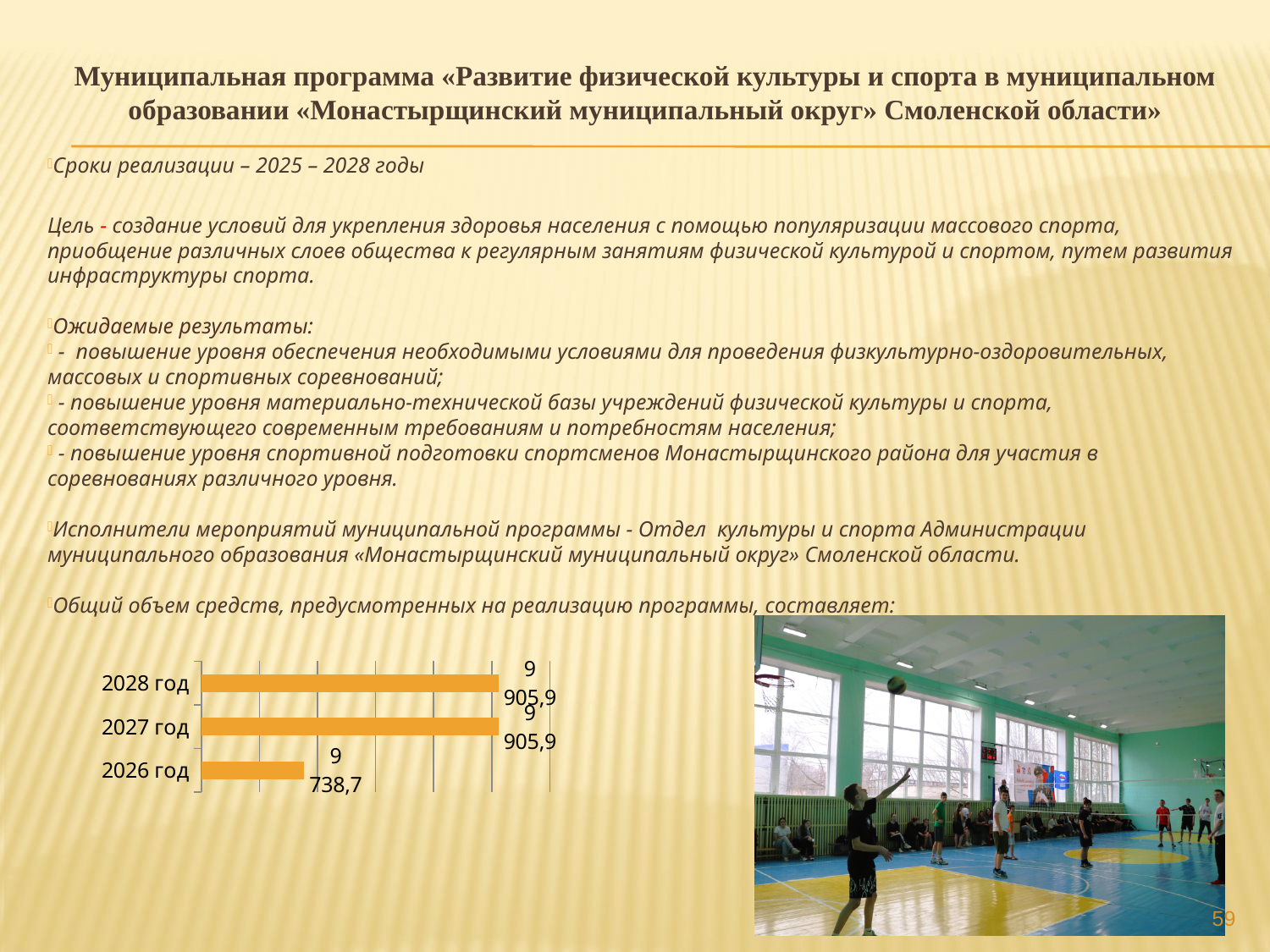
What kind of chart is shown on the slide? bar chart What colour are the bars in the chart? orange Does the value rise or fall from 2026 год to 2027 год? rise What is the value shown for 2026 год? 9 738,7 How many years (categories) are shown in the chart? 3 Are the values for 2027 год and 2028 год the same or different? the same What is the difference between the values for 2028 год and 2026 год? 167,2 Which year has the lowest value in the chart? 2026 год What is the sum of the values for all three years shown in the chart? 29 550,5 What is the value shown for 2027 год? 9 905,9 What is the value shown for 2028 год? 9 905,9 Which is larger, the value for 2027 год or the value for 2026 год? 2027 год